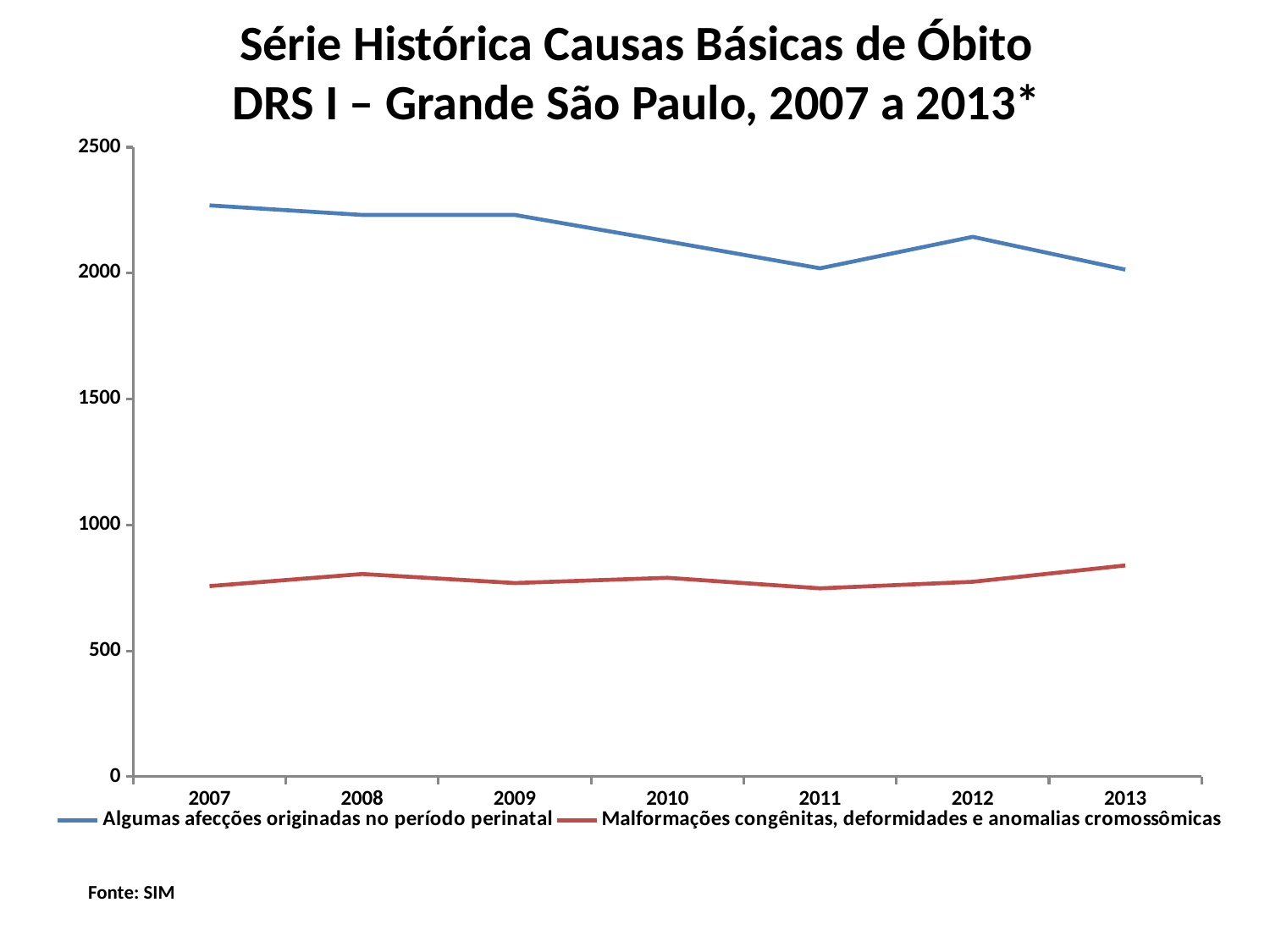
Does the line for 'Algumas afecções originadas no período perinatal' generally rise or fall from 2007 to 2013? fall What is the source cited below the chart? SIM How many series does the legend list? 2 Is the value for 'Algumas afecções originadas no período perinatal' in 2010 greater or less than 2500? less In which year is the value for 'Algumas afecções originadas no período perinatal' highest? 2007 In 2012, which series has the larger value: 'Algumas afecções originadas no período perinatal' or 'Malformações congênitas, deformidades e anomalias cromossômicas'? Algumas afecções originadas no período perinatal Is the value for 'Malformações congênitas, deformidades e anomalias cromossômicas' in 2011 greater or less than 500? greater Is the value for 'Algumas afecções originadas no período perinatal' in 2007 greater or less than 2000? greater How many years are plotted along the x axis? 7 In which year is the value for 'Malformações congênitas, deformidades e anomalias cromossômicas' highest? 2013 What kind of chart is shown on the slide? line chart